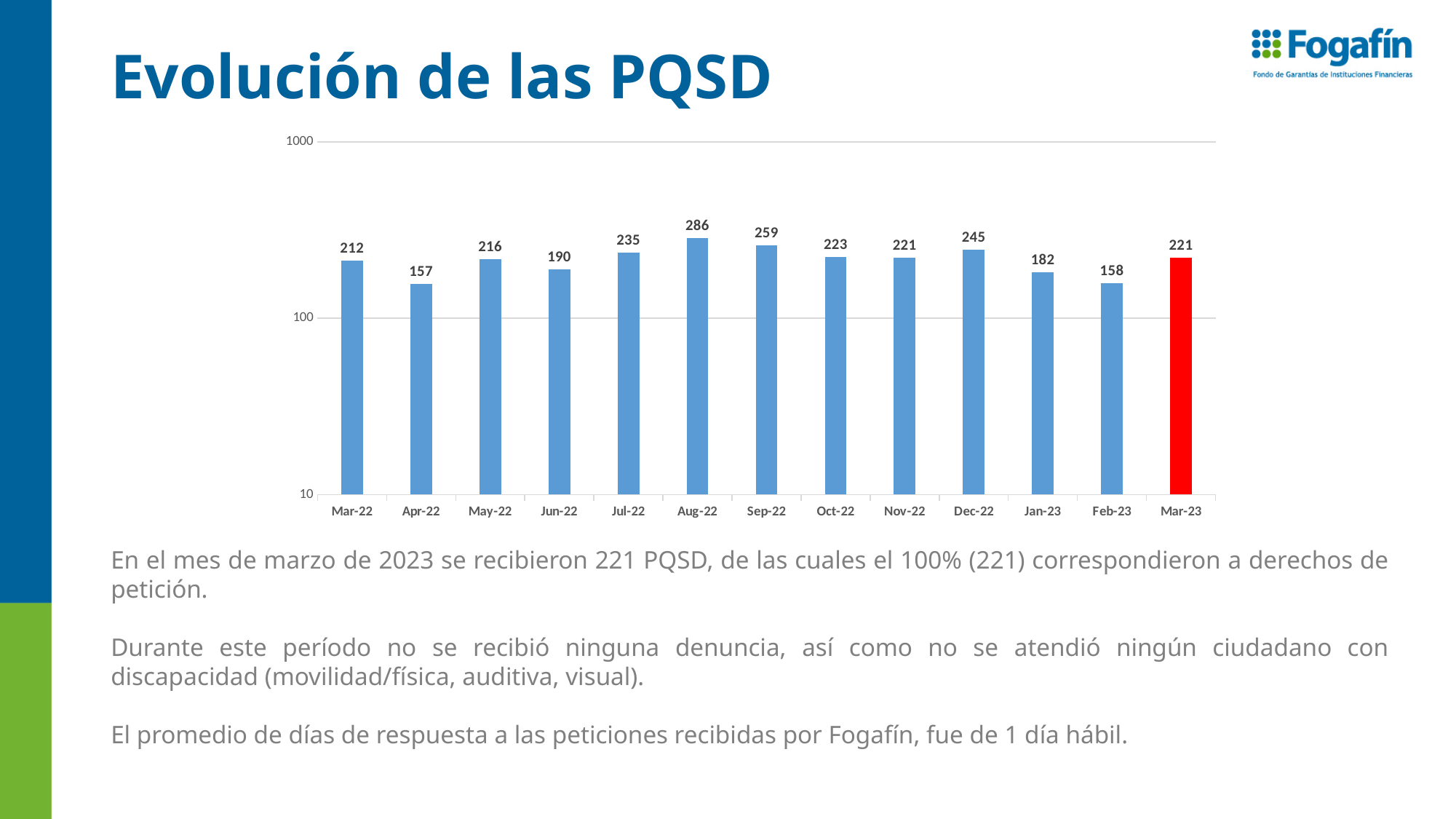
Which month has the lowest value? Apr-22 What is the value for Aug-22? 286 Which is larger, the value for Dec-22 or the value for Jan-23? Dec-22 Is the value for Jun-22 greater or less than 100? greater What is the difference between the values for Mar-22 and Mar-23? 9 What is the difference between the values for Aug-22 and Feb-23? 128 Which month has the highest value? Aug-22 Which bar is coloured red instead of blue? Mar-23 What kind of chart is shown on the slide? bar chart How many months are shown on the x axis? 13 What is the value for Mar-23? 221 What is the value for Feb-23? 158